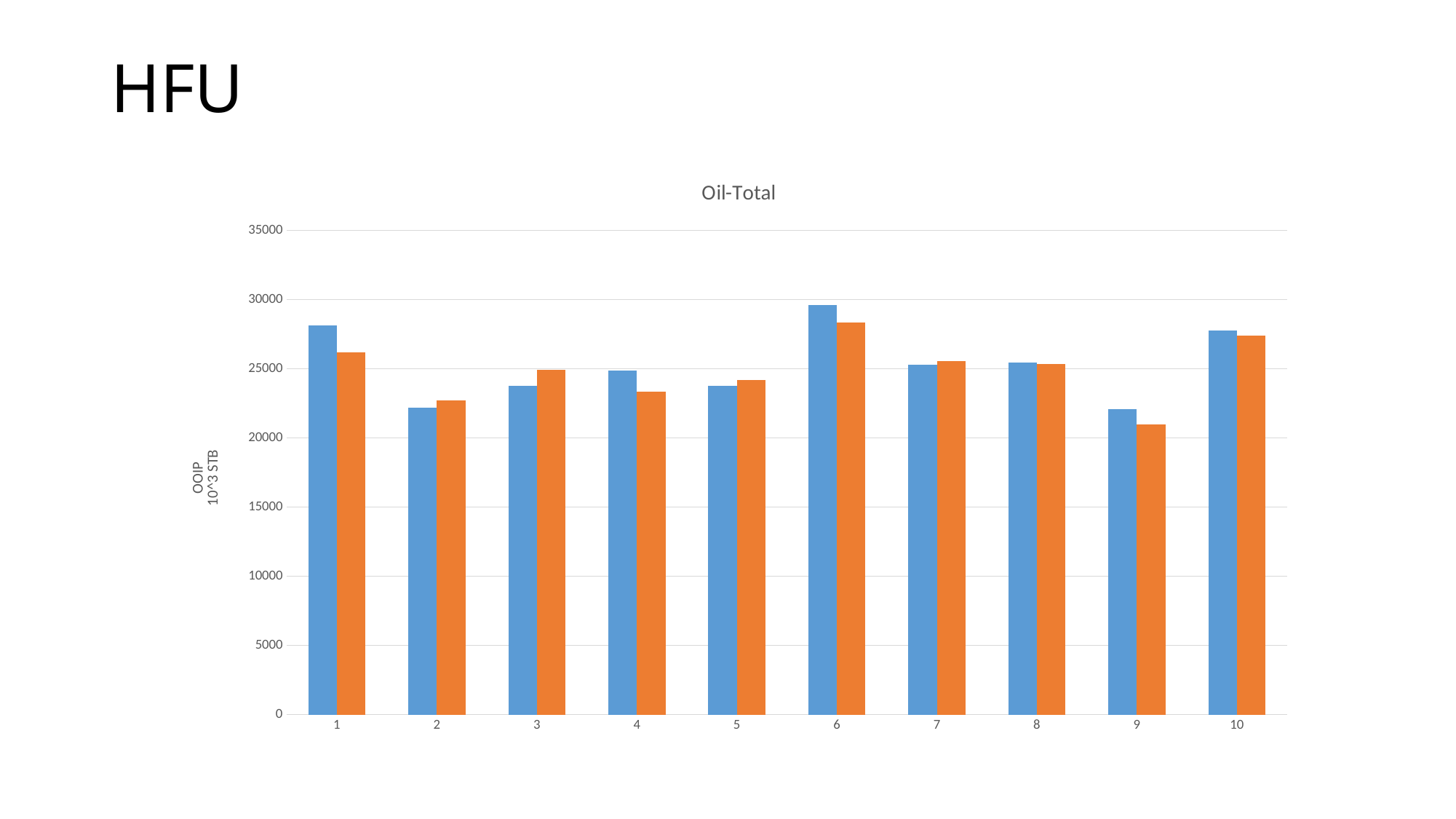
Which category has the tallest blue bar? 6 Is the blue bar for category 6 greater or less than 25000? greater How many categories are shown on the x axis of the chart? 10 What is the label of the vertical axis? OOIP 10^3 STB Which category has the tallest orange bar? 6 Which category has the shortest orange bar? 9 What kind of chart is shown on the slide? bar chart For category 1, which bar is taller, the blue or the orange? blue Is the orange bar for category 9 greater or less than 25000? less For category 3, which bar is taller, the blue or the orange? orange What is the title of the chart? Oil-Total Is the blue bar for category 2 greater or less than 25000? less